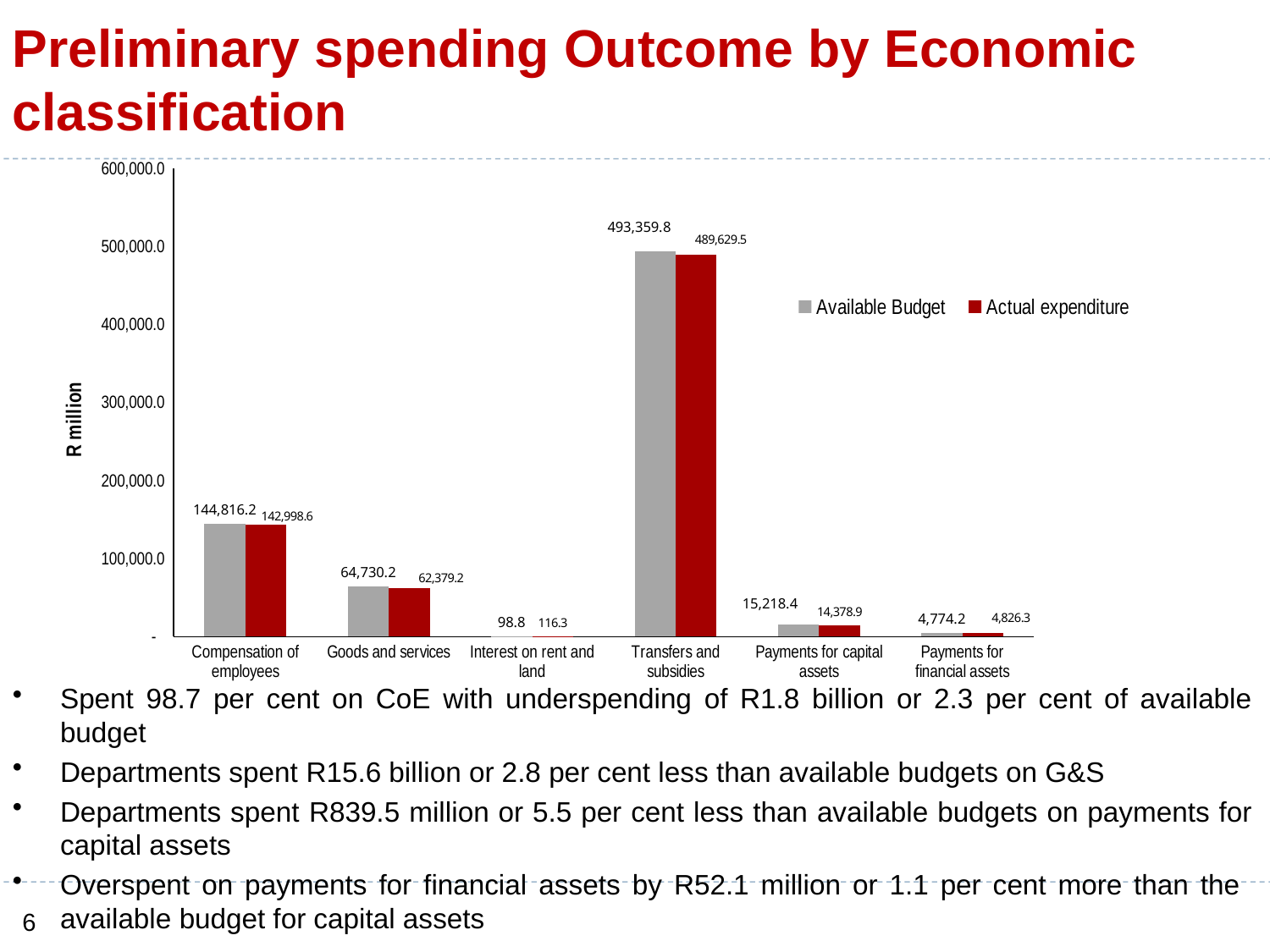
What is the Available Budget for Transfers and subsidies? 493,359.8 What is the difference between the Available Budget and Actual expenditure for Goods and services? 2,351.0 What is the difference between the Available Budget and Actual expenditure for Payments for capital assets? 839.5 How many categories are shown on the x axis of the chart? 6 Which category has the lowest Actual expenditure? Interest on rent and land For Payments for financial assets, which is larger: the Available Budget or the Actual expenditure? Actual expenditure Which category has the highest Available Budget? Transfers and subsidies What type of chart is shown on the slide? Bar chart What is the Available Budget for Interest on rent and land? 98.8 What is the Actual expenditure for Payments for capital assets? 14,378.9 How many series does the chart legend list? 2 What is the Actual expenditure for Compensation of employees? 142,998.6